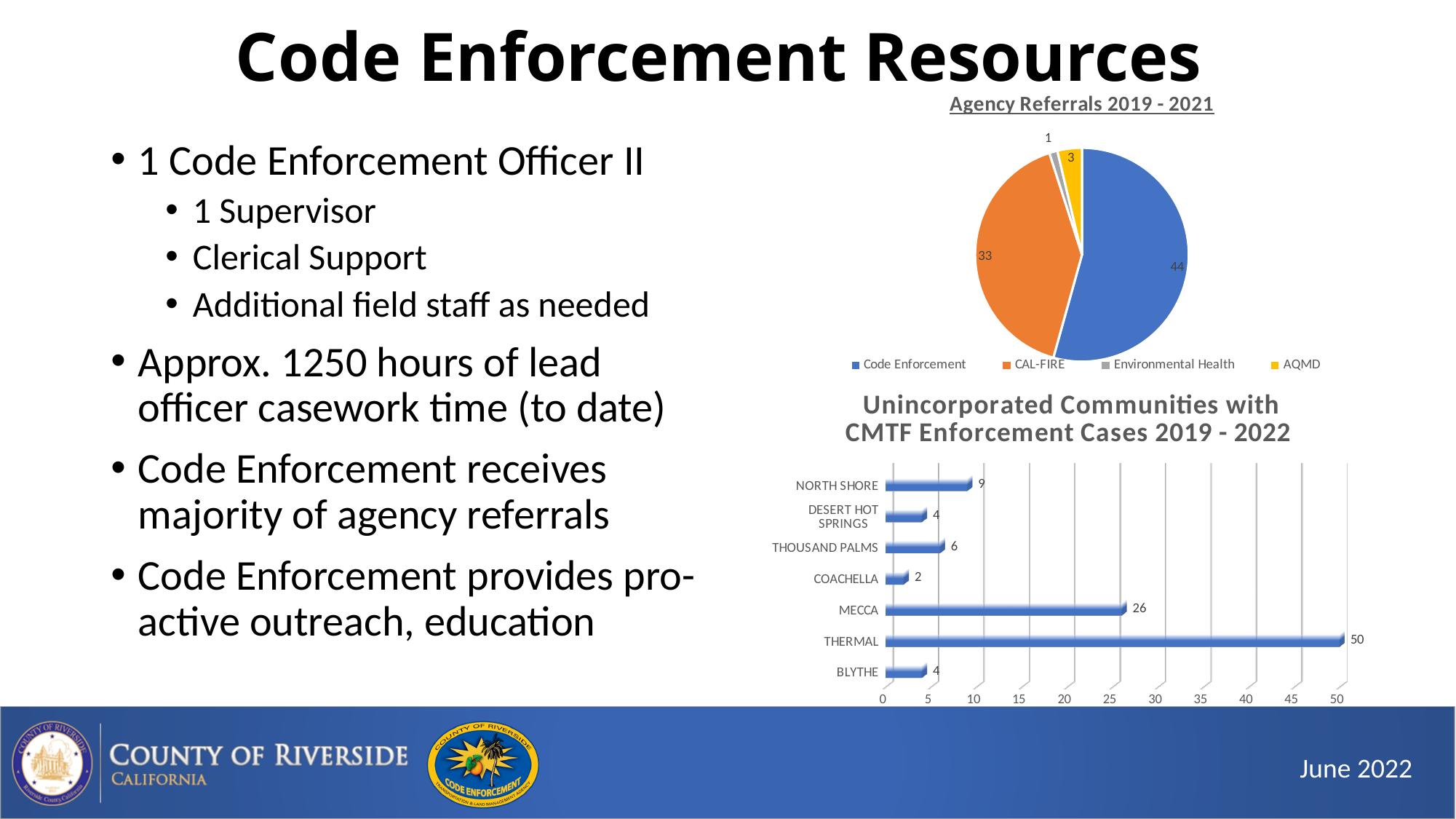
In the Unincorporated Communities with CMTF Enforcement Cases 2019 - 2022 chart, which is larger, the value for North Shore or the value for Thousand Palms? North Shore In the Agency Referrals 2019 - 2021 pie chart, what is the value for CAL-FIRE? 33 How many entries does the legend of the Agency Referrals 2019 - 2021 pie chart list? 4 What kind of chart is the Unincorporated Communities with CMTF Enforcement Cases 2019 - 2022 chart? Bar chart In the Agency Referrals 2019 - 2021 pie chart, which agency has the smallest slice? Environmental Health In the Unincorporated Communities with CMTF Enforcement Cases 2019 - 2022 chart, how many communities are shown? 7 In the Unincorporated Communities with CMTF Enforcement Cases 2019 - 2022 chart, which community has the highest value? Thermal In the Unincorporated Communities with CMTF Enforcement Cases 2019 - 2022 chart, which community has the lowest value? Coachella In the Agency Referrals 2019 - 2021 pie chart, what colour is the AQMD slice? Yellow In the Agency Referrals 2019 - 2021 pie chart, which agency has the largest slice? Code Enforcement In the Agency Referrals 2019 - 2021 pie chart, what is the difference between the Code Enforcement and CAL-FIRE values? 11 In the Unincorporated Communities with CMTF Enforcement Cases 2019 - 2022 chart, what is the value for Mecca? 26